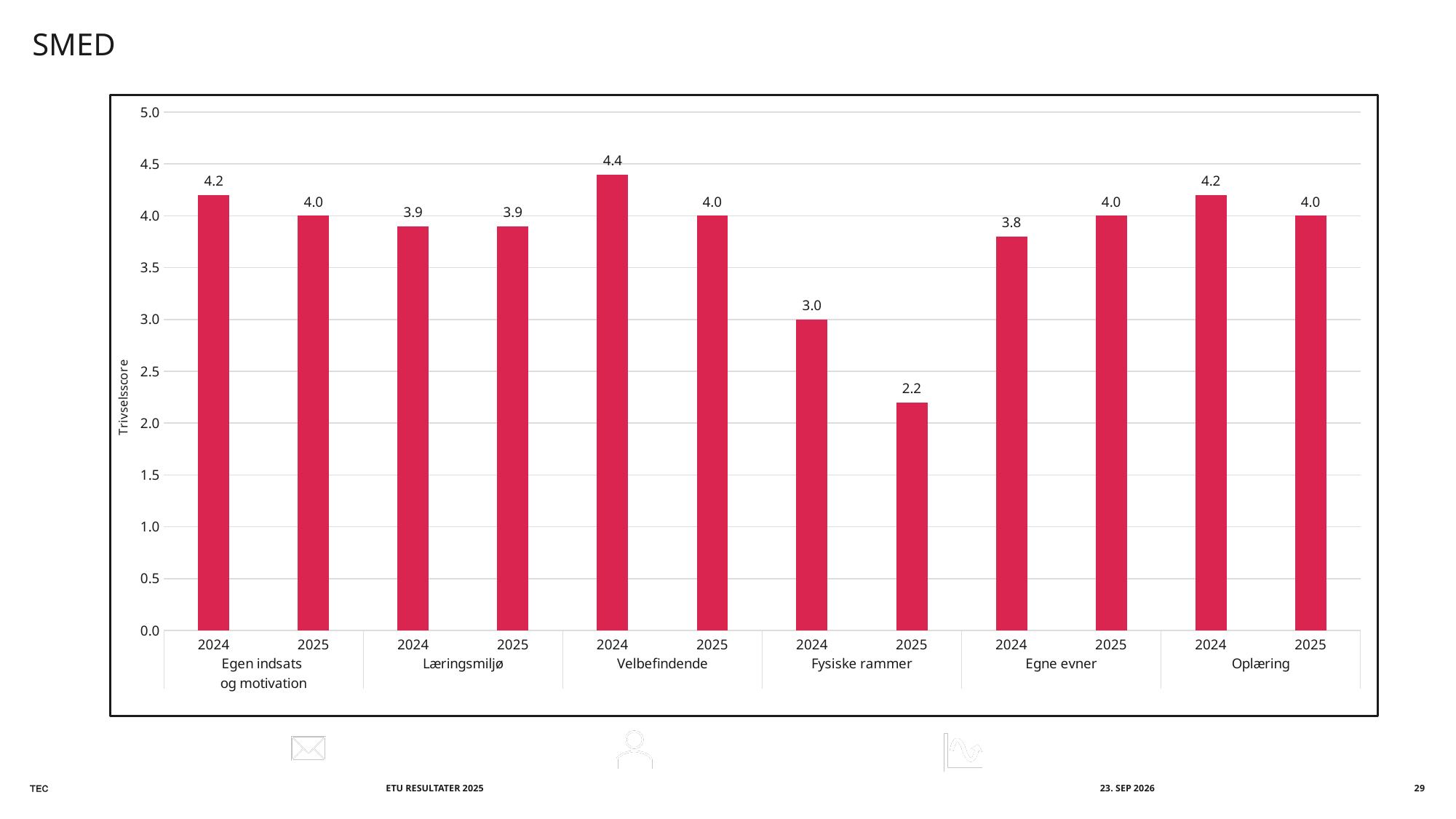
How many bars are plotted on the chart? 12 Which bar has the highest value on the chart? Velbefindende 2024 What is the value for Læringsmiljø in 2025? 3.9 What kind of chart is shown on the slide? Bar chart Which bar has the lowest value on the chart? Fysiske rammer 2025 What is the value for Egne evner in 2024? 3.8 What is the value for Fysiske rammer in 2025? 2.2 Which is larger: the 2024 value for Egne evner or the 2025 value for Egne evner? 2025 What is the difference between the 2024 and 2025 values for Fysiske rammer? 0.8 What is the value for Velbefindende in 2024? 4.4 What is the difference between the 2024 and 2025 values for Velbefindende? 0.4 What is the label on the vertical axis of the chart? Trivselsscore